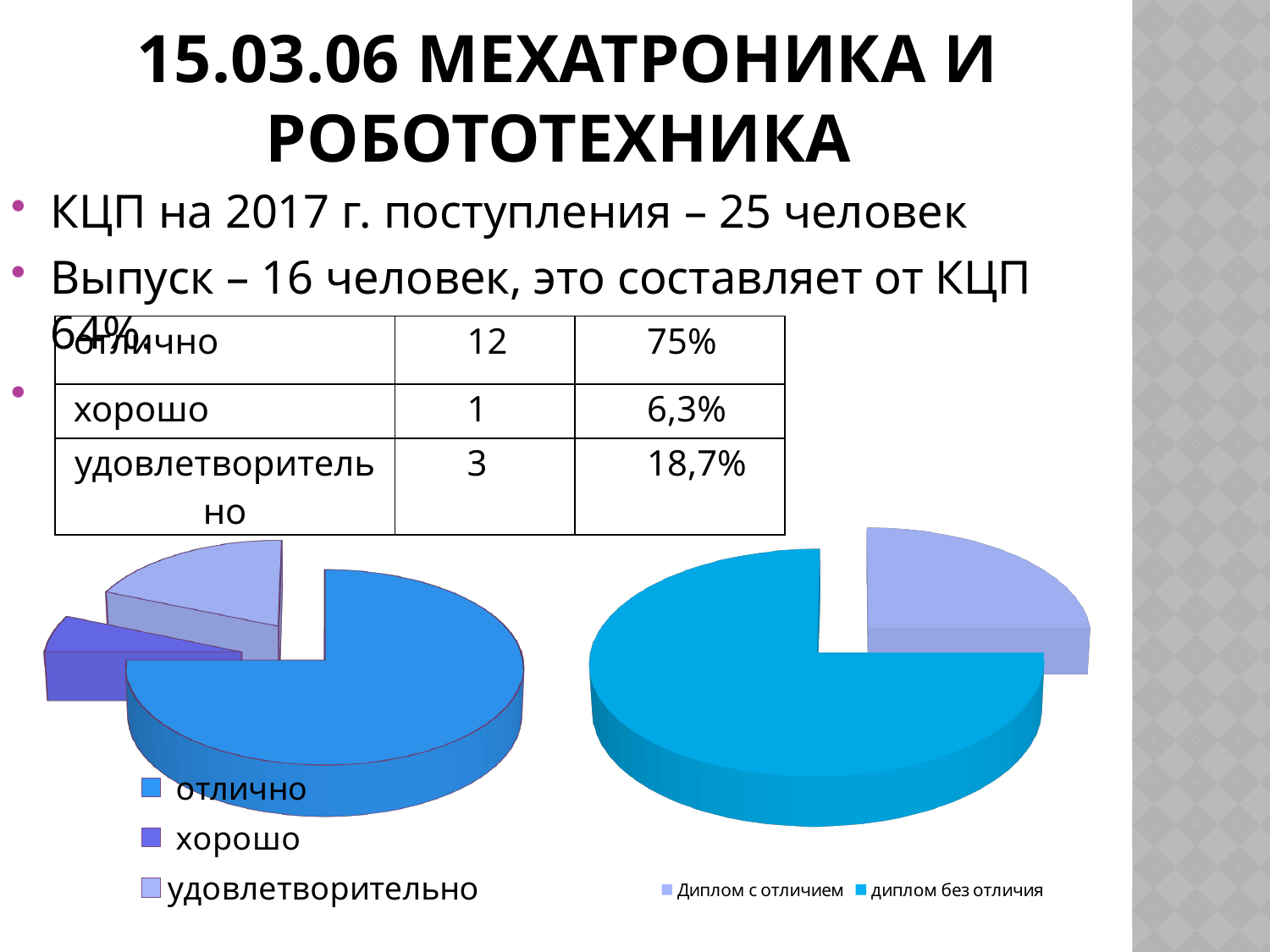
How many slices does the right pie chart have? 2 In the left pie chart, which category has the smallest slice? хорошо According to the table above the left pie chart, what share does отлично have? 75% How many slices does the left pie chart have? 3 What kind of chart is the right chart on the slide? pie chart In the right pie chart, which category has the larger slice? диплом без отличия How many entries does the legend of the right pie chart list? 2 What are the two legend entries of the right pie chart? Диплом с отличием, диплом без отличия In the left pie chart, which category has the largest slice? отлично How many entries does the legend of the left pie chart list? 3 In the left pie chart, which slice is larger: удовлетворительно or хорошо? удовлетворительно What kind of chart is the left chart on the slide? pie chart